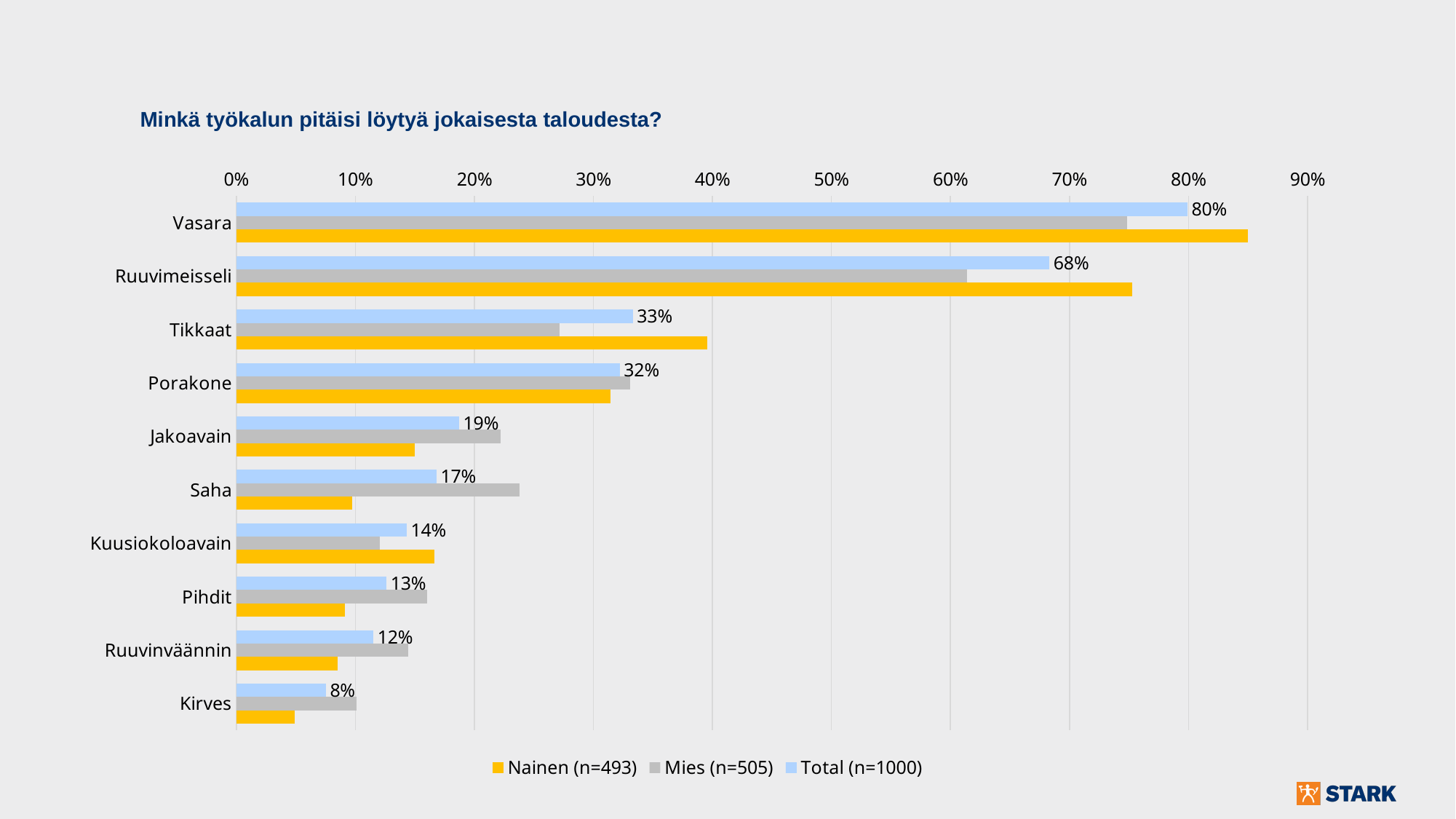
What is the Total (n=1000) value for Kuusiokoloavain? 14% How many series does the legend list? 3 What is the difference between the Total (n=1000) values for Vasara and Ruuvimeisseli? 12% Is the Nainen (n=493) value for Vasara greater or less than 80%? greater Which tool has the highest Total (n=1000) value? Vasara Is the Mies (n=505) value for Tikkaat greater or less than 30%? less What is the Total (n=1000) value for Ruuvimeisseli? 68% What kind of chart is shown on the slide? Bar chart For Saha, which is larger: the Nainen (n=493) value or the Mies (n=505) value? Mies (n=505) Which tool has the lowest Total (n=1000) value? Kirves What is the Total (n=1000) value for Vasara? 80% How many tools are listed on the chart? 10